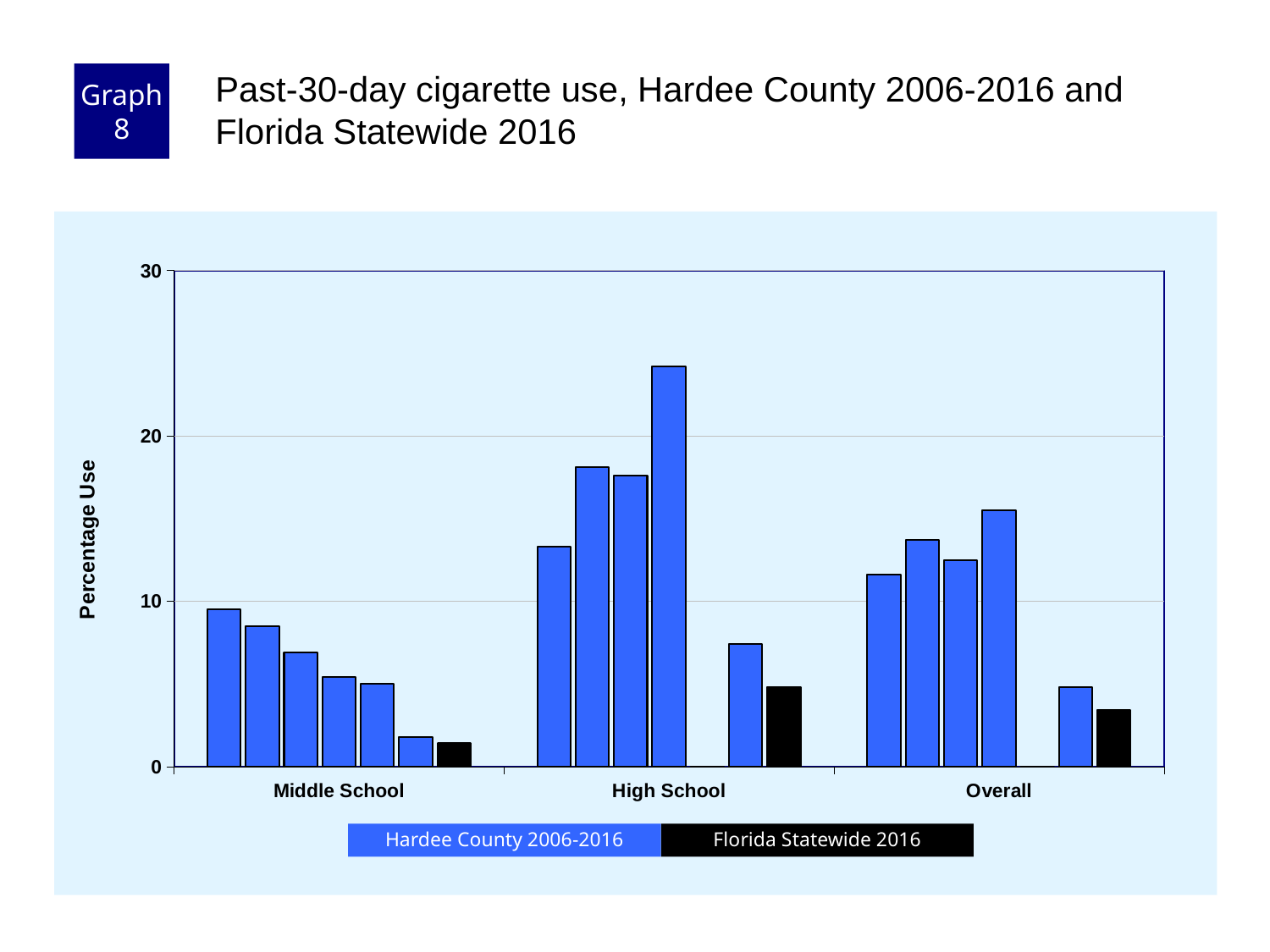
Which category group contains the tallest bar on the chart? High School How many category groups are shown on the x axis? 3 Do the Hardee County 2006-2016 bars in the Middle School group rise or fall from left to right? fall Is the Florida Statewide 2016 bar for Middle School greater or less than 10? less Is the tallest bar in the Overall group greater or less than 10? greater What kind of chart is shown on the slide? bar chart Which category group has the lowest Florida Statewide 2016 bar? Middle School Is the tallest Hardee County 2006-2016 bar in the High School group greater or less than 20? greater How many series does the legend list? 2 Which series is shown in black in the legend? Florida Statewide 2016 What is the label on the y axis? Percentage Use